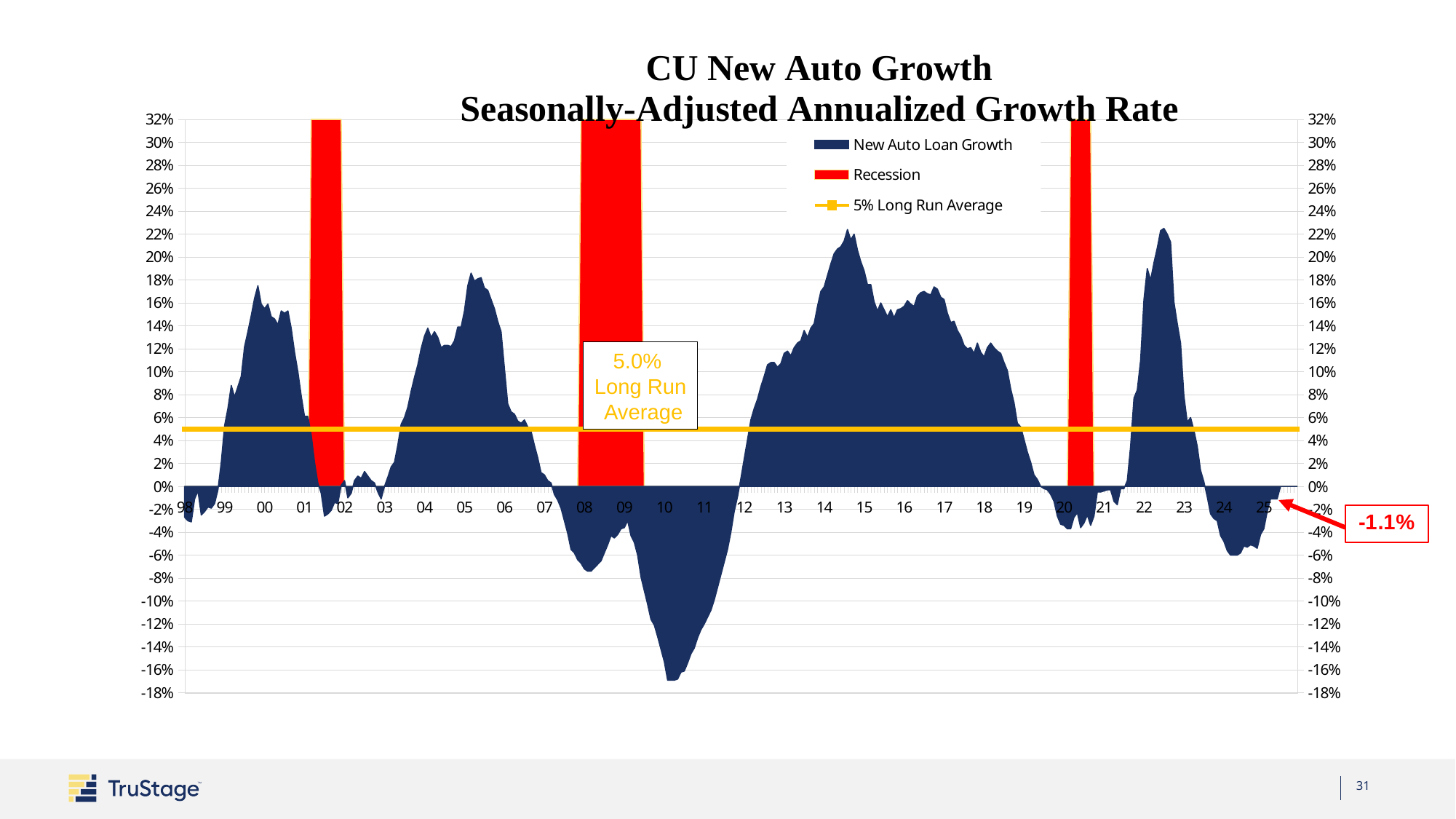
Between 2022 and 2024, does New Auto Loan Growth rise or fall? fall What kind of chart is shown on the slide? area chart Is the lowest New Auto Loan Growth value around 2011 greater or less than -14%? less What is the title of the chart? CU New Auto Growth Seasonally-Adjusted Annualized Growth Rate Is the peak New Auto Loan Growth value around 2022 greater or less than 20%? greater How many entries does the chart legend list? 3 Which is larger: the peak New Auto Loan Growth around 2005 or the peak around 2014? the peak around 2014 What value is the Long Run Average line labeled with on the chart? 5.0% What is the most recent New Auto Loan Growth value called out on the chart? -1.1% Is the peak New Auto Loan Growth value around 2014-2015 greater or less than 20%? greater Around which year does New Auto Loan Growth reach its lowest value? 2010 How many recession periods are shaded on the chart? 3